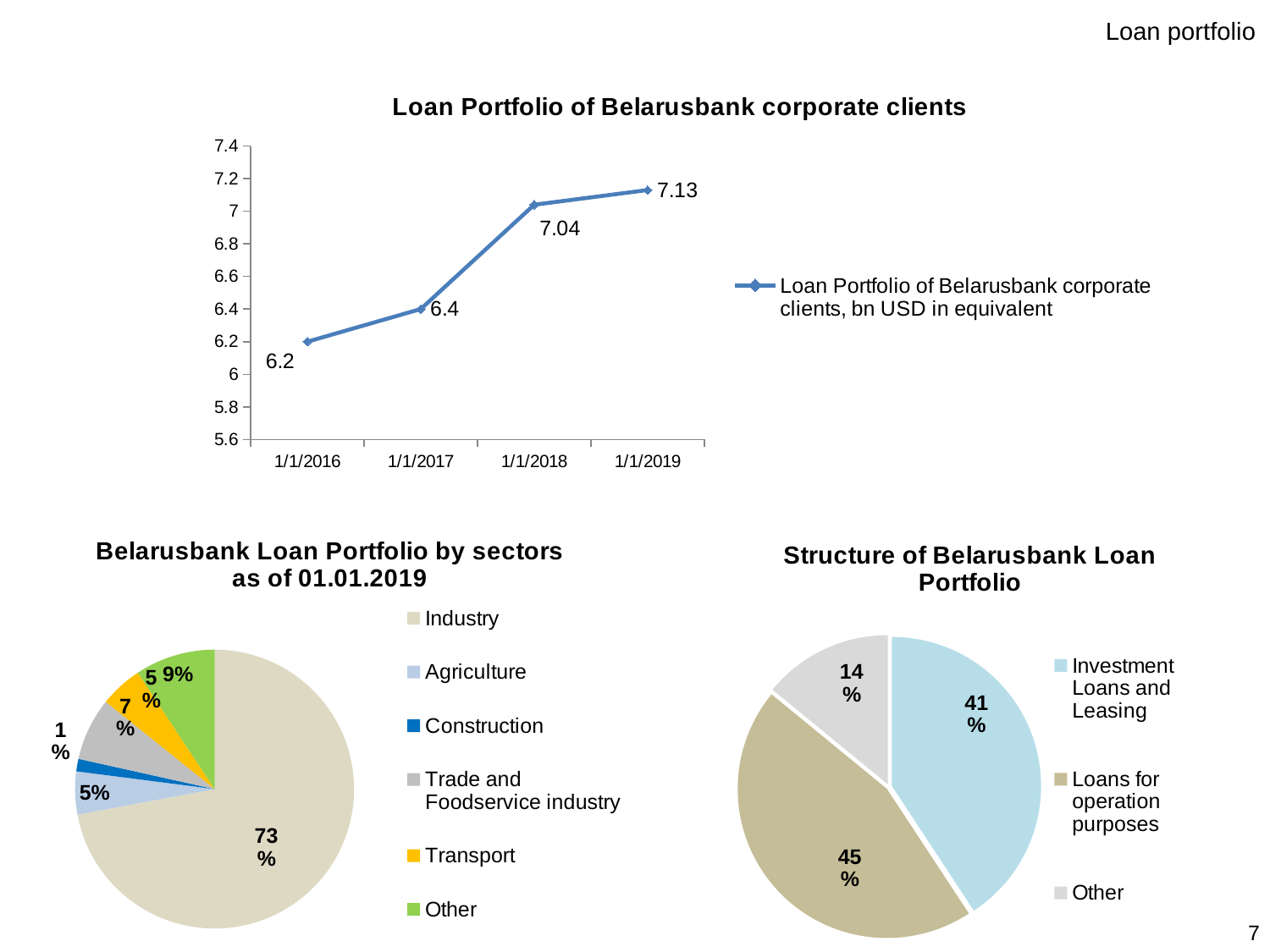
In the pie chart 'Structure of Belarusbank Loan Portfolio', what share do Loans for operation purposes have? 45% How many categories does the legend of the pie chart 'Belarusbank Loan Portfolio by sectors as of 01.01.2019' list? 6 What kind of chart is 'Loan Portfolio of Belarusbank corporate clients'? line chart In the pie chart 'Structure of Belarusbank Loan Portfolio', which is larger: Investment Loans and Leasing or Other? Investment Loans and Leasing In the chart 'Loan Portfolio of Belarusbank corporate clients', which date has the highest value? 1/1/2019 In the chart 'Loan Portfolio of Belarusbank corporate clients', what is the value for 1/1/2016? 6.2 In the chart 'Loan Portfolio of Belarusbank corporate clients', what is the difference between the values for 1/1/2019 and 1/1/2017? 0.73 In the pie chart 'Belarusbank Loan Portfolio by sectors as of 01.01.2019', what share does Industry have? 73% In the chart 'Loan Portfolio of Belarusbank corporate clients', what is the value for 1/1/2018? 7.04 How many data points are plotted in the chart 'Loan Portfolio of Belarusbank corporate clients'? 4 In the pie chart 'Belarusbank Loan Portfolio by sectors as of 01.01.2019', which sector has the smallest share? Construction In the chart 'Loan Portfolio of Belarusbank corporate clients', do the values rise or fall from 1/1/2016 to 1/1/2019? rise